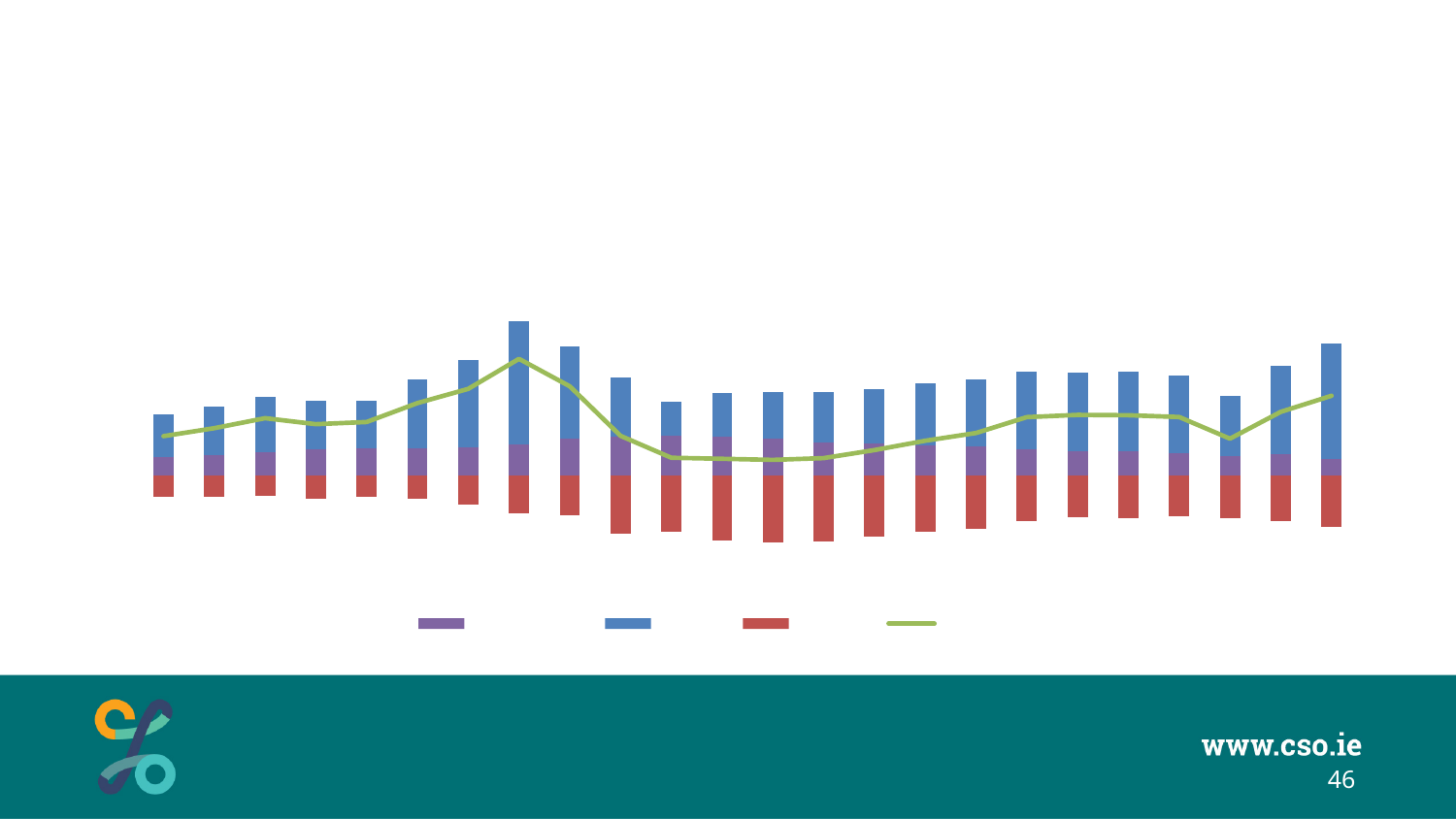
What kind of chart is shown on the slide? A stacked bar chart combined with a line Counting from the left, which bar has the tallest blue segment? The 8th bar How many bars are plotted in the chart? 24 Does the green line end higher or lower than where it starts on the left? Higher Which colour segments extend below the baseline in the stacked bars? Red What colour is the line series in the chart? Green How many series does the legend list? 4